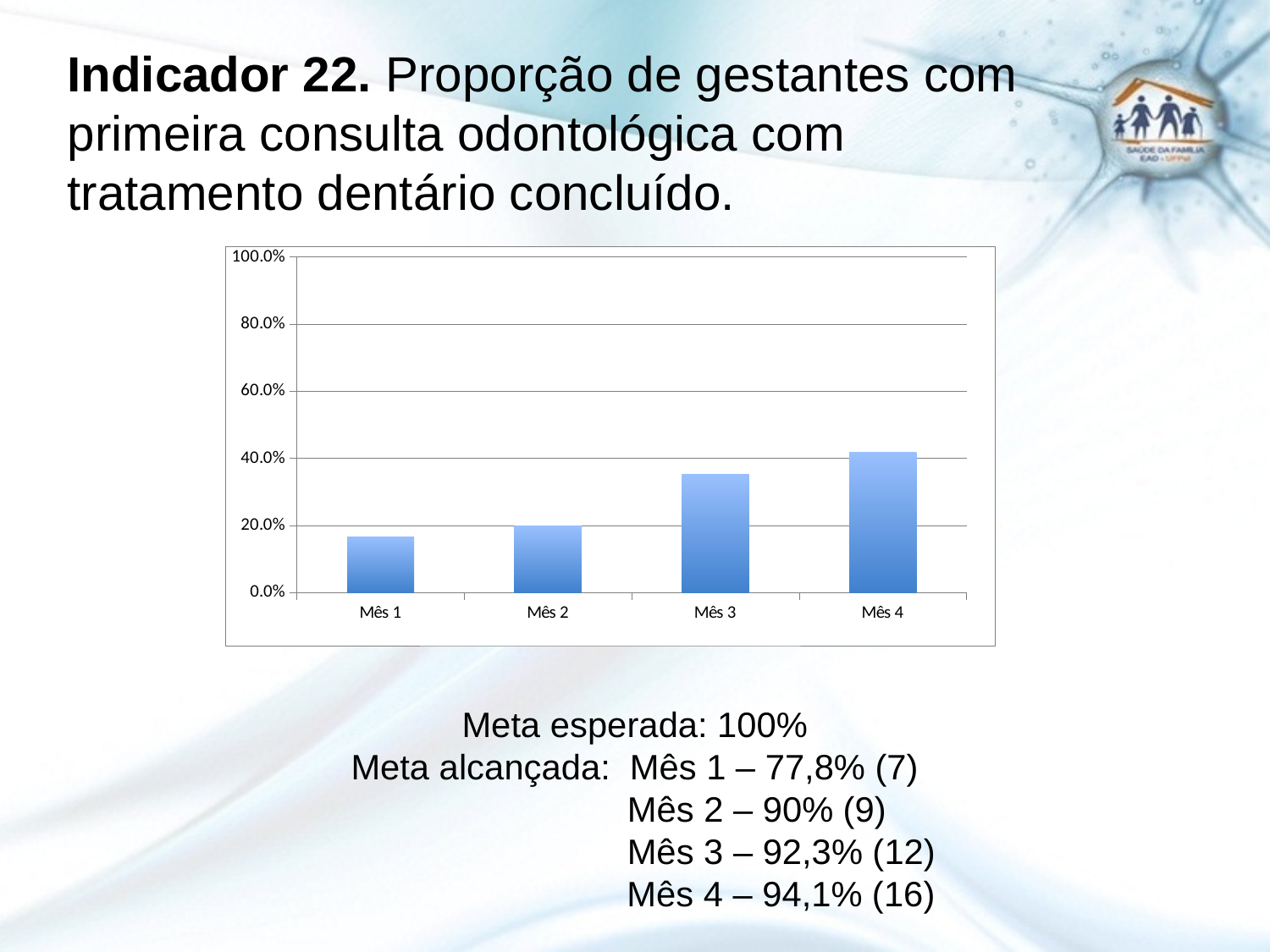
Which is larger, the value for Mês 3 or the value for Mês 2? Mês 3 Is the value for Mês 4 greater or less than 60.0%? less Is the value for Mês 4 greater or less than 20.0%? greater Is the value for Mês 3 greater or less than 20.0%? greater What is the highest value shown on the vertical axis of the chart? 100.0% Which month has the lowest bar on the chart? Mês 1 Which month has the highest bar on the chart? Mês 4 What kind of chart is shown on the slide? bar chart Do the values rise or fall from Mês 1 to Mês 4? rise How many categories (months) are plotted on the chart? 4